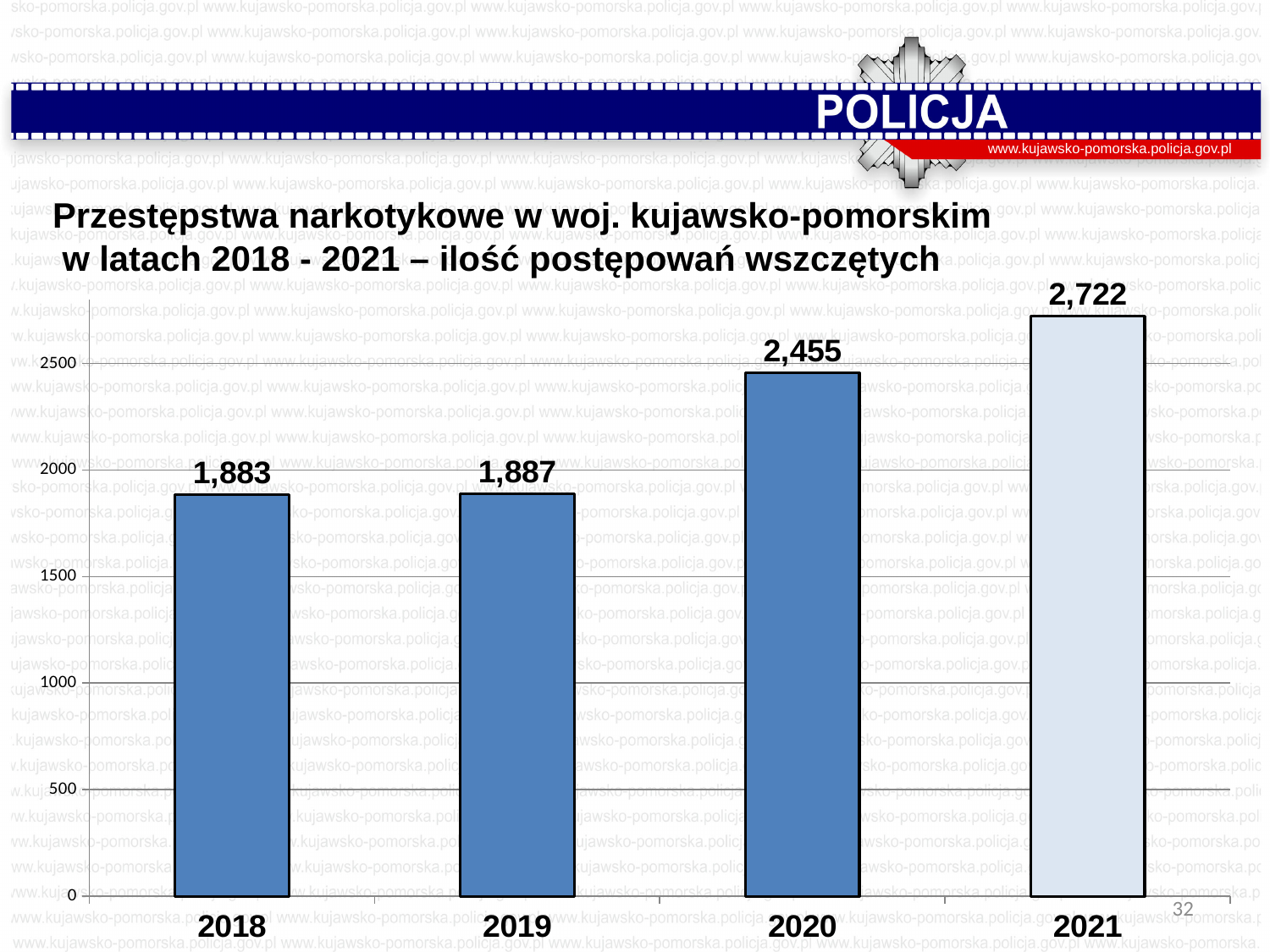
Which year has the highest value? 2021 What kind of chart is shown on the slide? bar chart What is the value for 2020? 2,455 Which is larger, the value for 2020 or the value for 2021? 2021 What is the value for 2018? 1,883 How many years are shown on the chart? 4 Do the values rise or fall from 2018 to 2021? rise Is the value for 2019 greater or less than 2000? less What is the difference between the values for 2020 and 2019? 568 Which year has the lowest value? 2018 What is the difference between the values for 2021 and 2020? 267 What is the value for 2021? 2,722